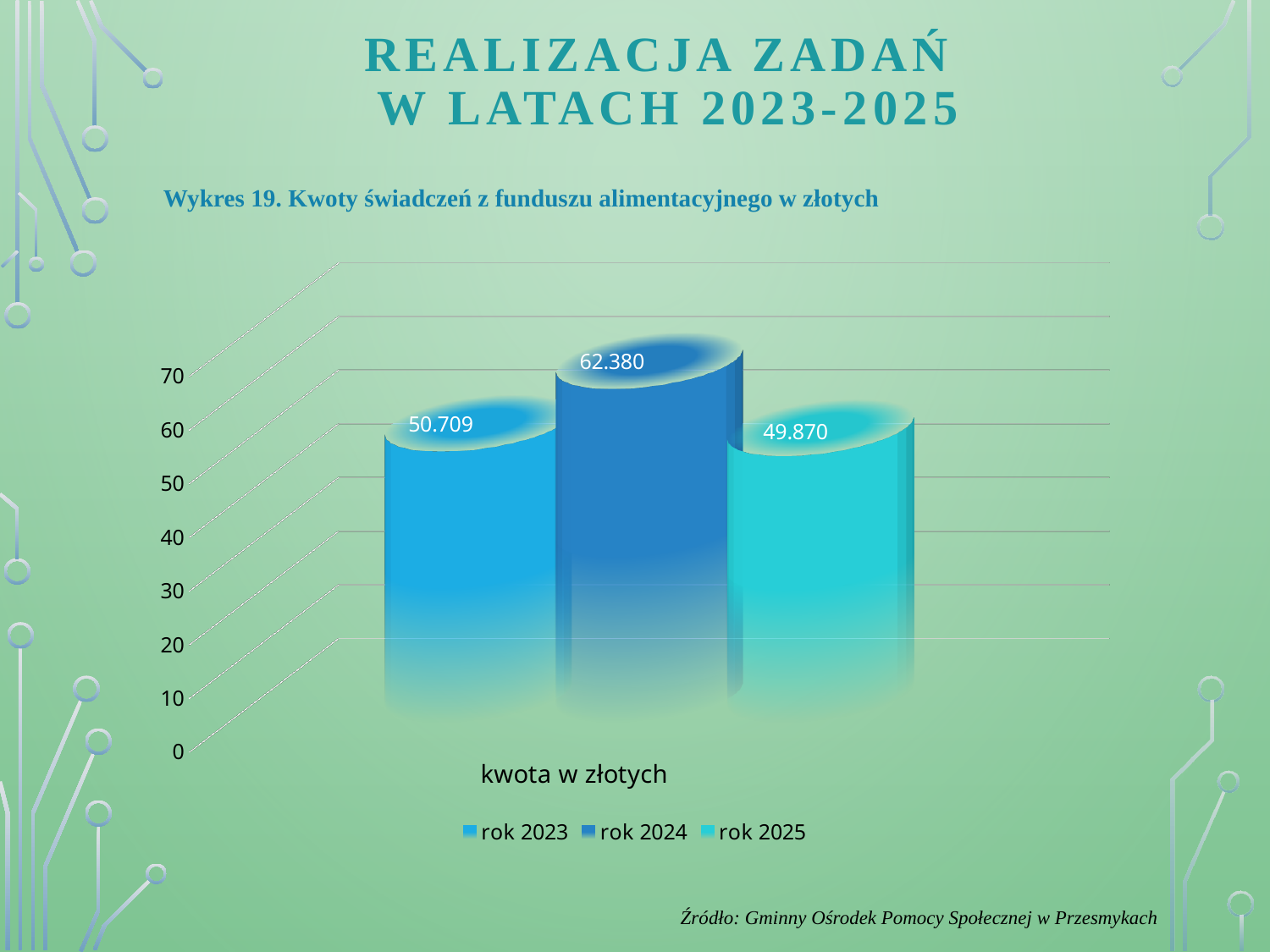
What is the difference between the values for rok 2024 and rok 2025? 12.510 What is the title of the chart (Wykres 19)? Kwoty świadczeń z funduszu alimentacyjnego w złotych What is the value for rok 2023 in the chart? 50.709 What is the value for rok 2024 in the chart? 62.380 How many series does the legend list? 3 What is the difference between the values for rok 2024 and rok 2023? 11.671 Is the value for rok 2023 greater or less than 40? greater What is the value for rok 2025 in the chart? 49.870 Which year has the lowest value in the chart? rok 2025 Which is larger, the value for rok 2023 or the value for rok 2025? rok 2023 Which year has the highest value in the chart? rok 2024 What kind of chart is shown on the slide? bar chart